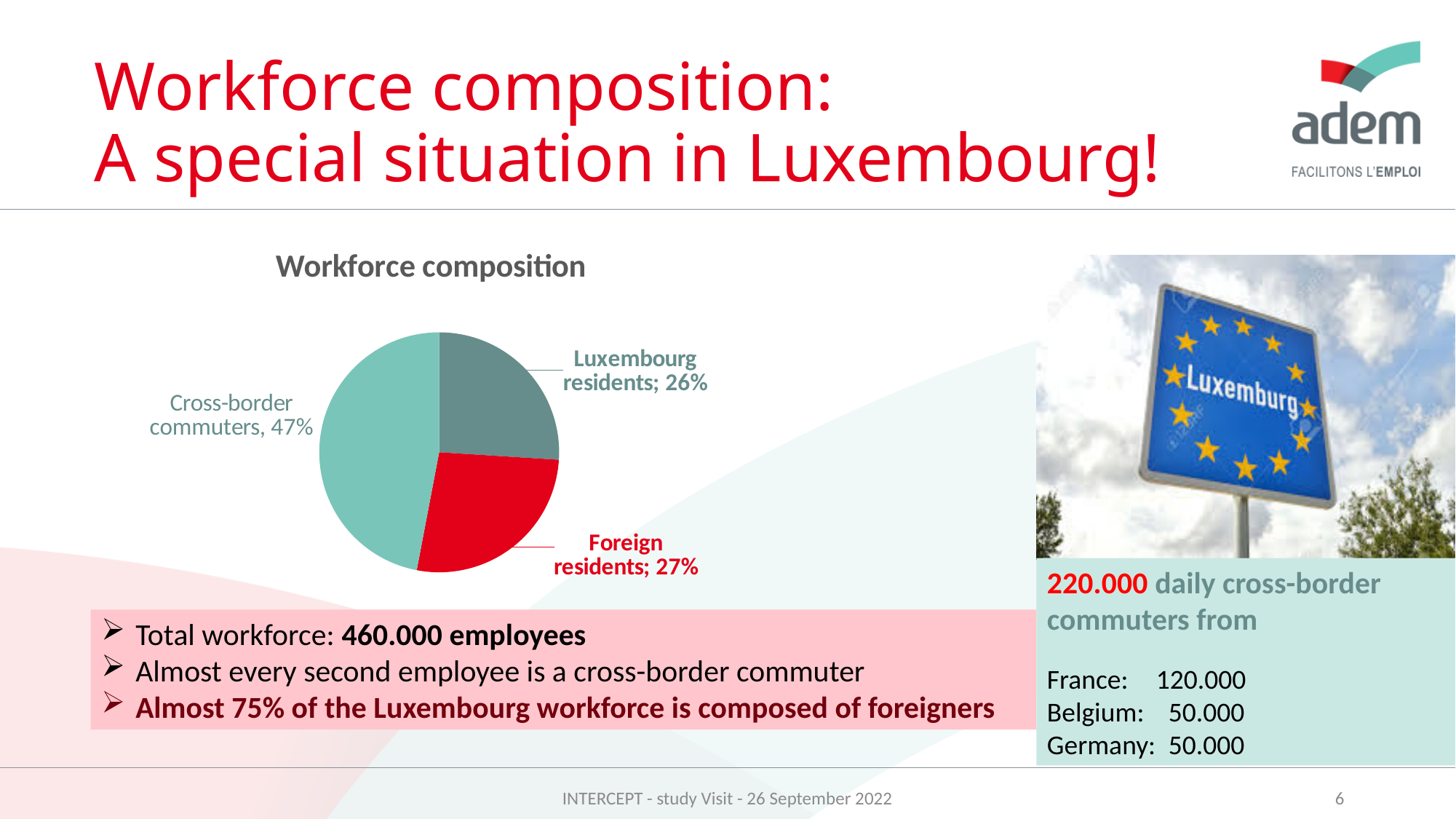
What colour is the slice for foreign residents? Red What is the title of the chart? Workforce composition Which is larger: the share of cross-border commuters or the share of Luxembourg residents? Cross-border commuters Which category has the smallest share of the pie chart? Luxembourg residents What share of the workforce is made up of foreign residents? 27% What is the difference in percentage points between cross-border commuters and foreign residents? 20 What share of the workforce is made up of Luxembourg residents? 26% Which category has the largest share of the pie chart? Cross-border commuters What share of the workforce is made up of cross-border commuters? 47% How many slices does the pie chart have? 3 What is the difference in percentage points between foreign residents and Luxembourg residents? 1 What type of chart is shown on the slide? Pie chart